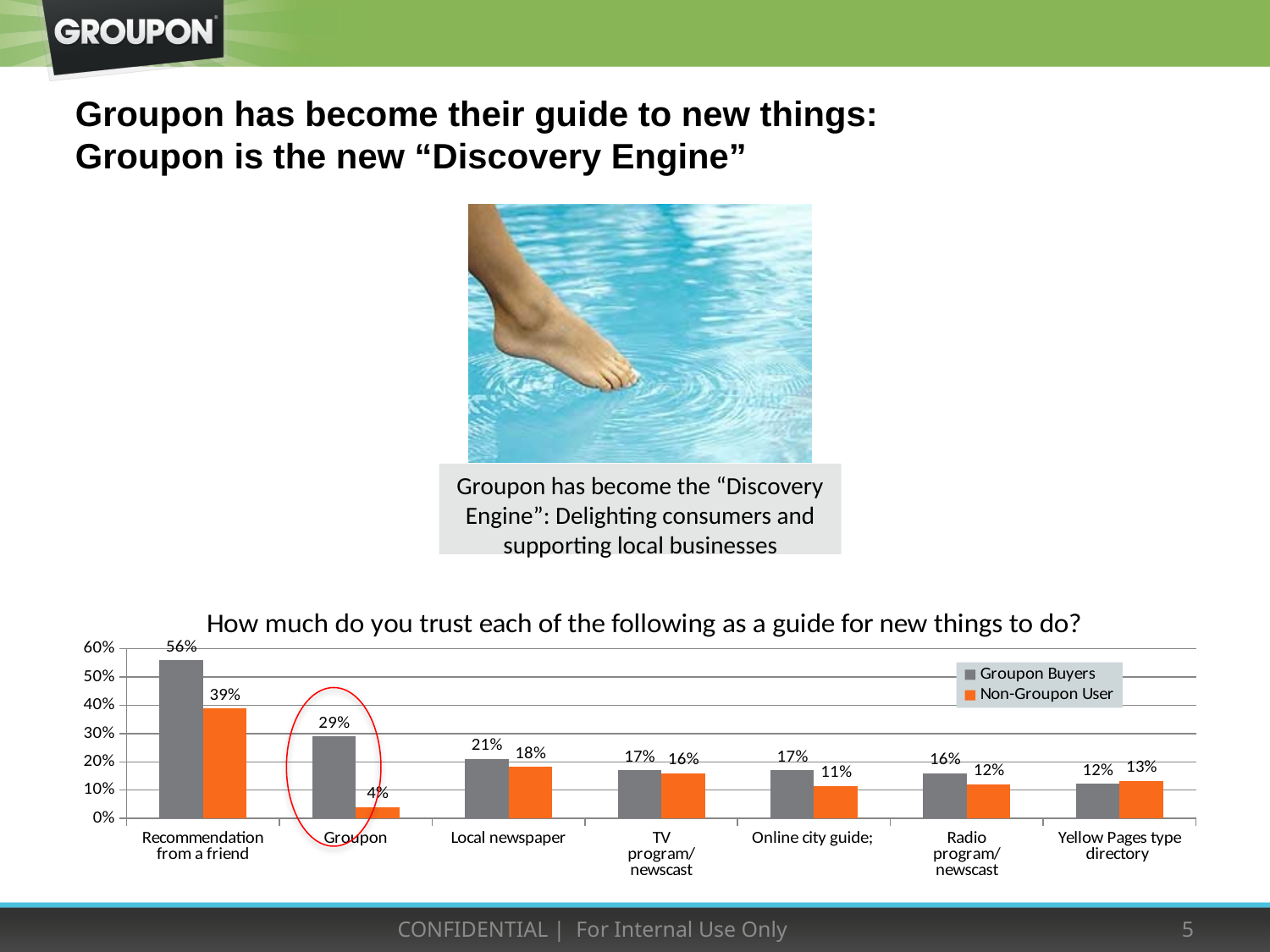
How many categories are shown on the x axis? 7 What is the value for Non-Groupon User for Groupon? 4% For Yellow Pages type directory, which series has the larger value, Groupon Buyers or Non-Groupon User? Non-Groupon User What kind of chart is shown on the slide? Bar chart What is the difference between Groupon Buyers and Non-Groupon User for Groupon? 25% Which category has the lowest value for Non-Groupon User? Groupon What is the value for Groupon Buyers for Recommendation from a friend? 56% What is the difference between Groupon Buyers and Non-Groupon User for Recommendation from a friend? 17% How many series does the legend list? 2 What is the value for Non-Groupon User for Online city guide? 11% What is the title of the chart? How much do you trust each of the following as a guide for new things to do? Which category has the highest value for Groupon Buyers? Recommendation from a friend